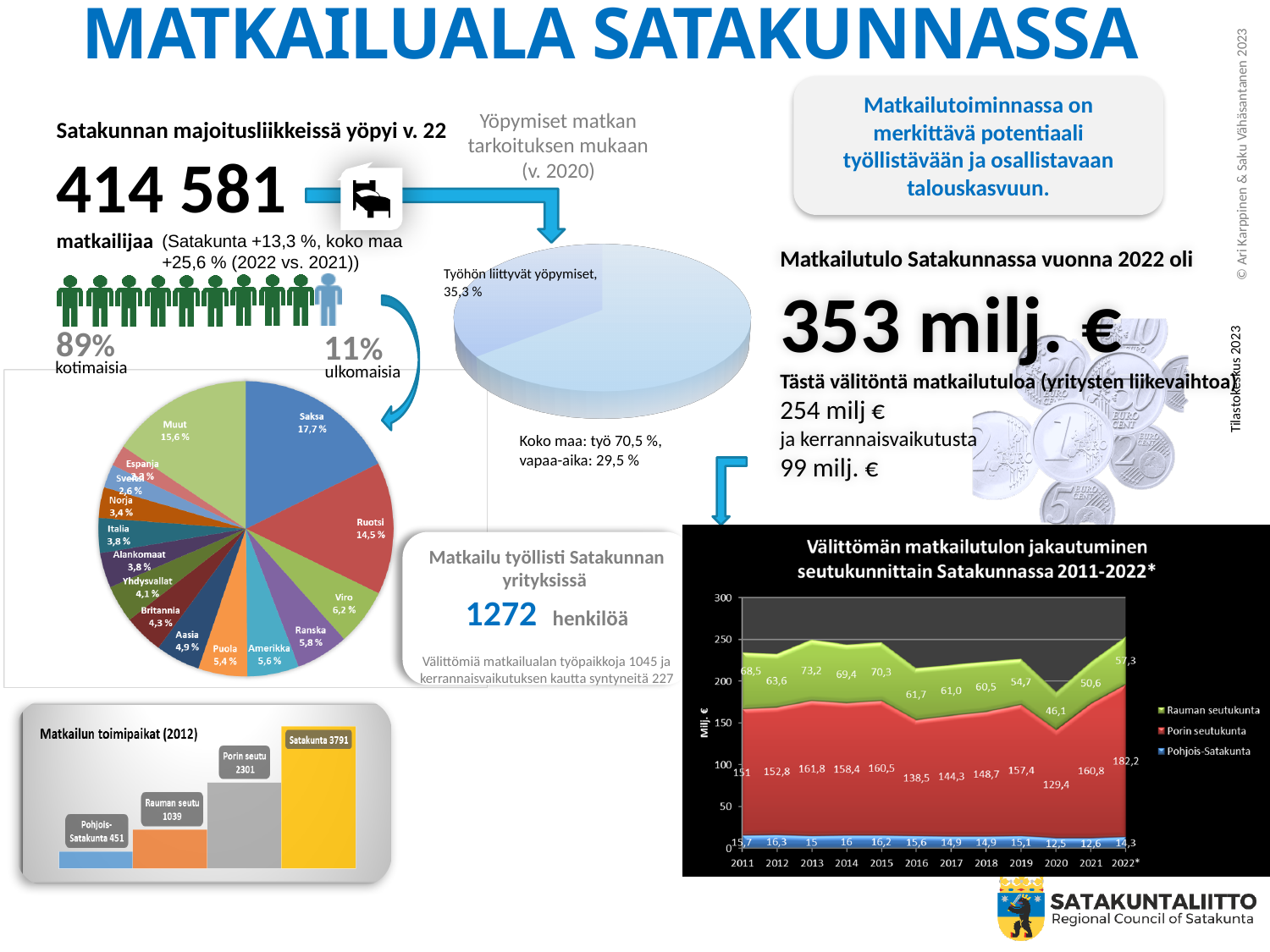
In the 'Välittömän matkailutulon jakautuminen seutukunnittain Satakunnassa 2011-2022*' chart, what is the total of the three series in 2020? 188,0 In the 'Matkailun toimipaikat (2012)' bar chart, which category has the lowest value? Pohjois-Satakunta In the pie chart of foreign visitors by country, what share does Saksa have? 17,7 % In the 'Matkailun toimipaikat (2012)' bar chart, what is the difference between Porin seutu and Rauman seutu? 1262 In the 'Yöpymiset matkan tarkoituksen mukaan (v. 2020)' pie chart, what share is labelled for Työhön liittyvät yöpymiset? 35,3 % In the 'Matkailun toimipaikat (2012)' chart, how many bars are shown? 4 In the pie chart of foreign visitors by country, which is larger, Ruotsi or Viro? Ruotsi In the 'Matkailun toimipaikat (2012)' bar chart, what is the value for Porin seutu? 2301 In the pie chart of foreign visitors by country, which named country has the largest share? Saksa In the 'Välittömän matkailutulon jakautuminen seutukunnittain Satakunnassa 2011-2022*' chart, in which year is the Rauman seutukunta value lowest? 2020 In the 'Välittömän matkailutulon jakautuminen seutukunnittain Satakunnassa 2011-2022*' chart, how many series does the legend list? 3 In the 'Välittömän matkailutulon jakautuminen seutukunnittain Satakunnassa 2011-2022*' chart, what is the value for Porin seutukunta in 2022*? 182,2